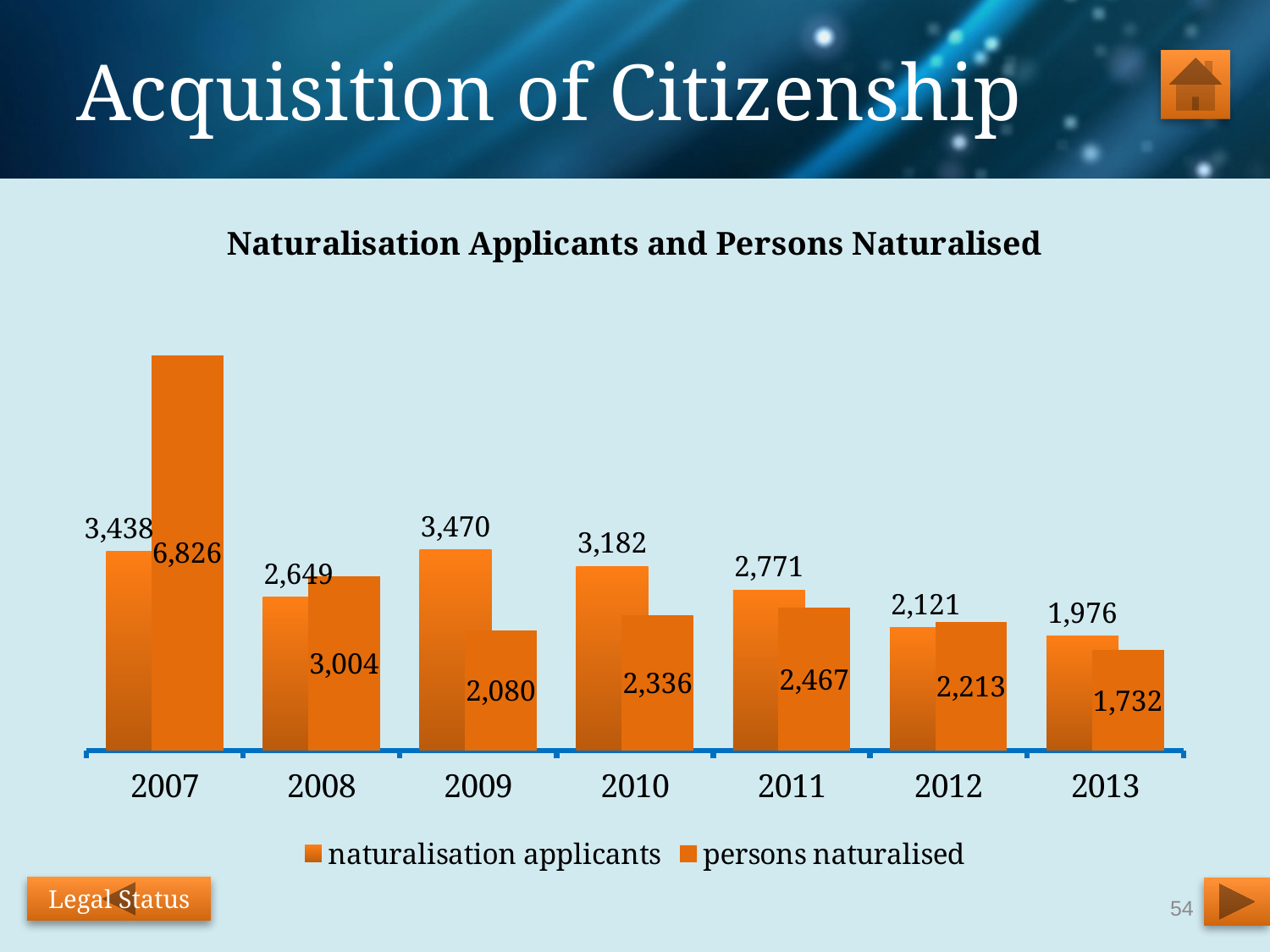
What kind of chart is shown on the slide? bar chart In 2012, which is larger: naturalisation applicants or persons naturalised? persons naturalised How many persons were naturalised in 2007? 6,826 What is the difference between persons naturalised and naturalisation applicants in 2007? 3,388 How many more naturalisation applicants than persons naturalised were there in 2009? 1,390 From 2009 to 2013, do the values for naturalisation applicants rise or fall? fall How many years are shown on the x axis? 7 In which year was the number of naturalisation applicants lowest? 2013 What is the value for persons naturalised in 2012? 2,213 What is the number of naturalisation applicants in 2009? 3,470 How many series does the legend list? 2 In which year was the number of persons naturalised highest? 2007